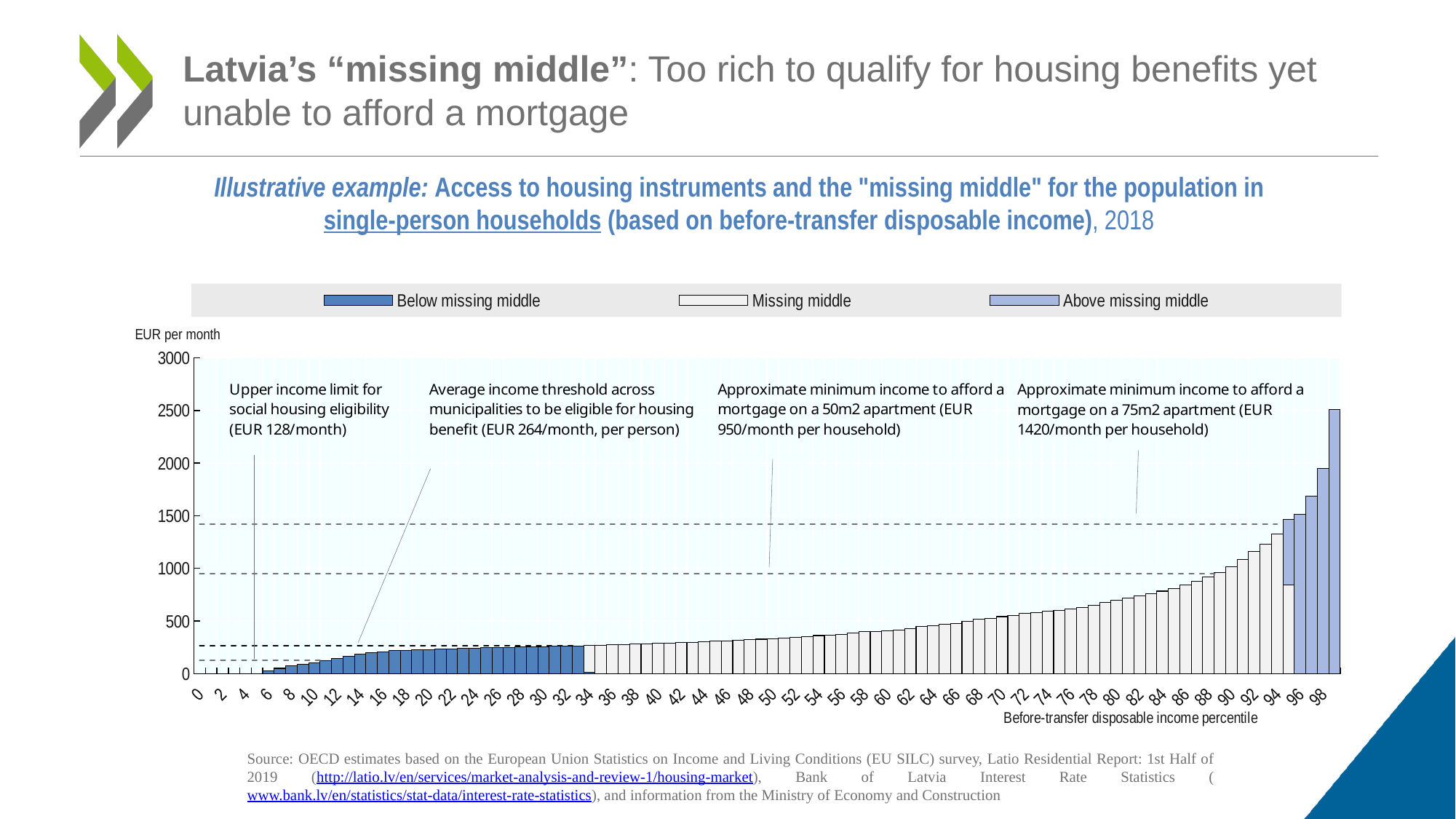
Is the value for the 20th percentile greater or less than 500? less According to the chart annotation, what is the approximate minimum income to afford a mortgage on a 75m2 apartment? EUR 1420/month per household Is the value for the 50th percentile greater or less than 500? less What unit is shown on the y axis of the chart? EUR per month What are the three series named in the legend? Below missing middle, Missing middle, Above missing middle Which series contains the tallest bar in the chart? Above missing middle How many series does the legend list? 3 Which has the larger value, the 30th percentile or the 90th percentile? 90th percentile Do the bar values rise or fall as the before-transfer disposable income percentile increases along the x axis? rise According to the chart annotation, what is the upper income limit for social housing eligibility? EUR 128/month Is the value for the 80th percentile greater or less than 500? greater What kind of chart is shown on the slide? bar chart